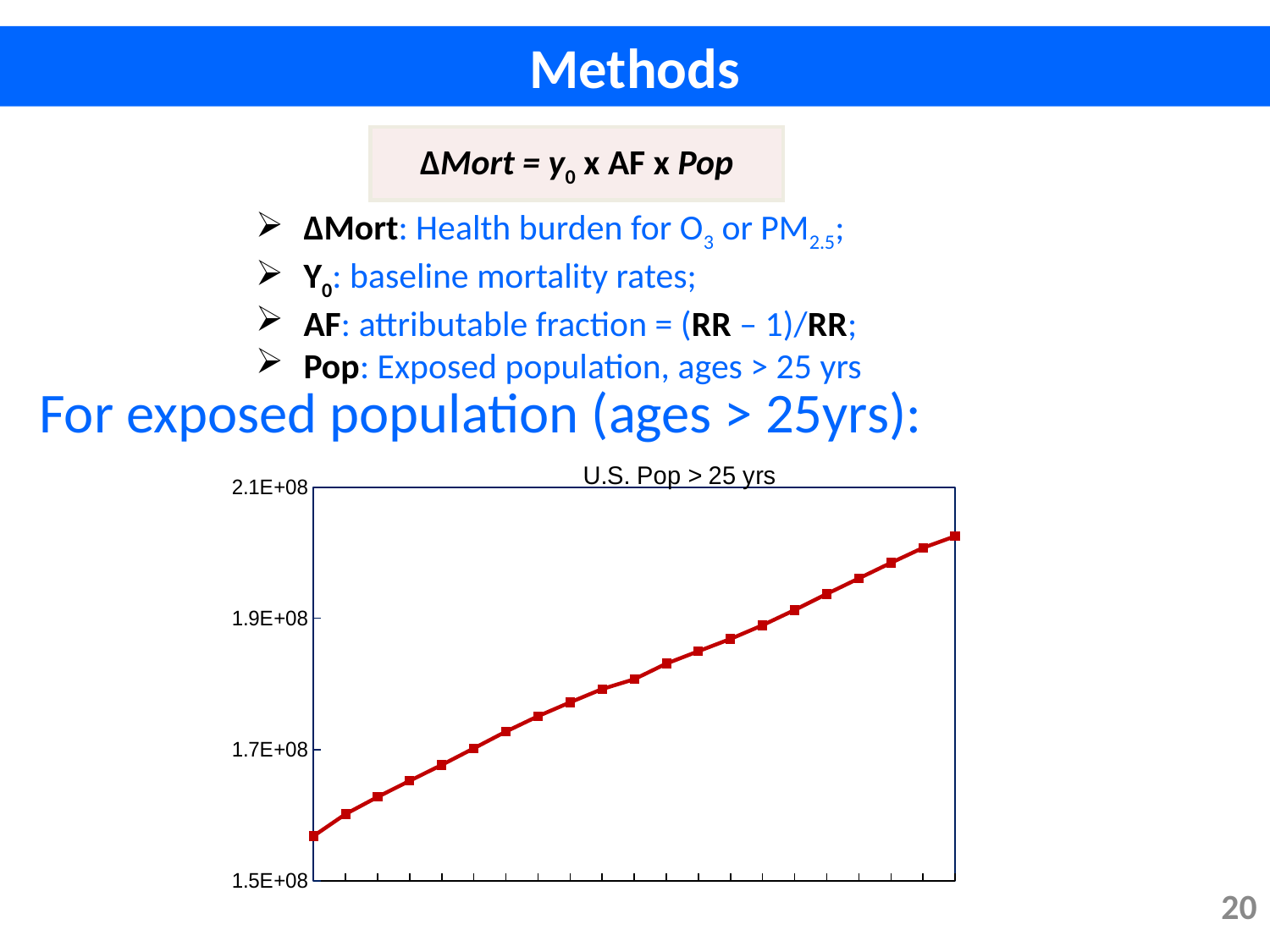
Is the value of the rightmost point on the line greater or less than 2.1E+08? less Is the value of the leftmost point larger or smaller than the value of the rightmost point? smaller What kind of chart is shown on the slide? line chart Do the values in the chart rise or fall from left to right along the x axis? rise Is the value of the leftmost point on the line greater or less than 1.7E+08? less Which point on the line has the lowest value, the leftmost or the rightmost? leftmost What is the lowest value shown on the y axis of the chart? 1.5E+08 How many data points are plotted on the line? 21 What is the title of the chart? U.S. Pop > 25 yrs Which point on the line has the highest value, the leftmost or the rightmost? rightmost Is the value of the rightmost point on the line greater or less than 1.9E+08? greater